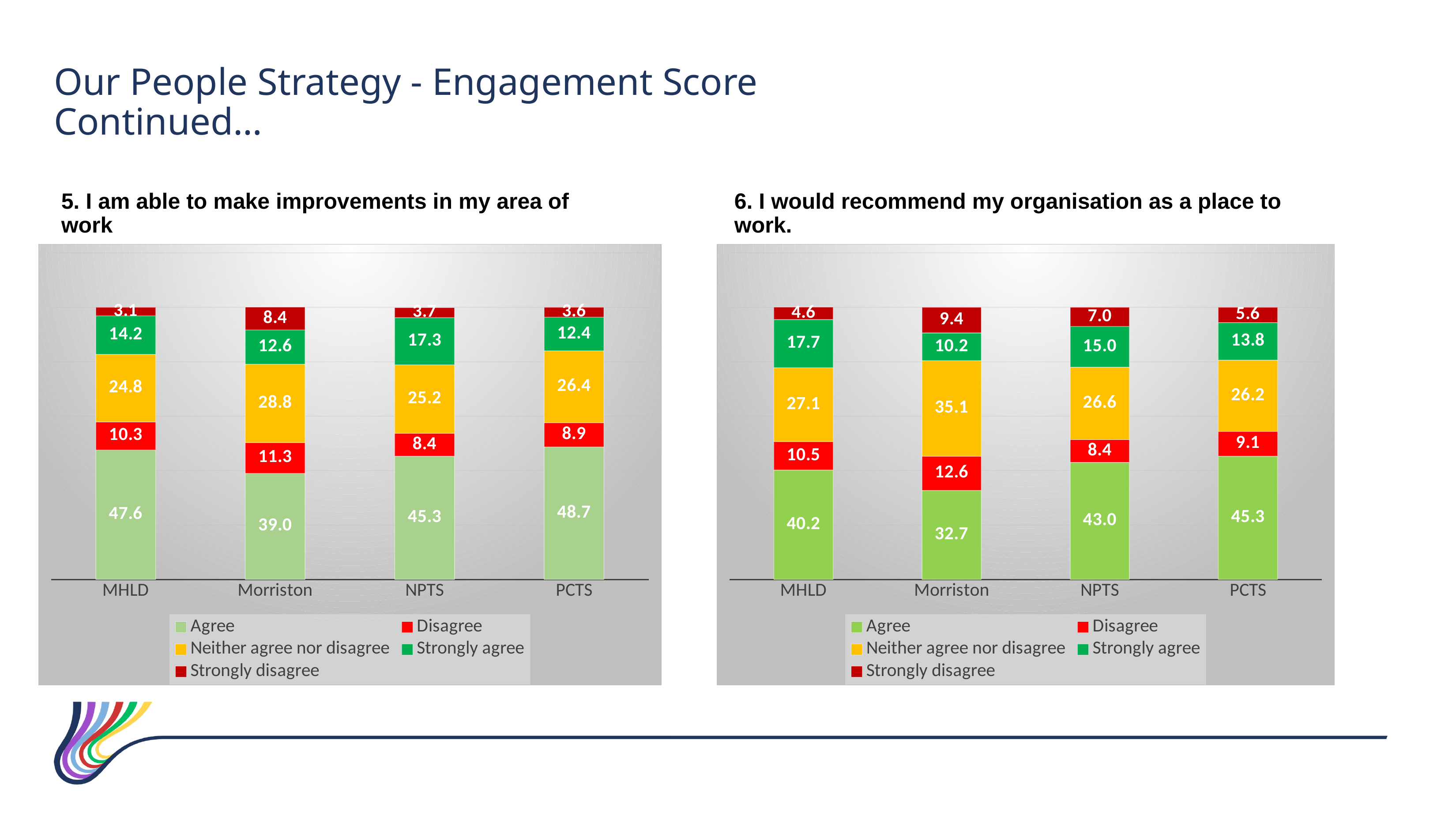
In the chart for question 5, which category has the highest Agree value? PCTS In the chart for question 6, which is larger: the Strongly disagree value for Morriston or for NPTS? Morriston In the chart for question 5, what is the Strongly disagree value for MHLD? 3.1 In the chart for question 6, what is the total of the stacked bar for NPTS? 100.0 In the chart for question 5 (I am able to make improvements in my area of work), what is the Agree value for Morriston? 39.0 How many series does the legend of the chart for question 5 list? 5 What kind of chart is used for question 5? Stacked bar chart In the chart for question 5, what is the difference between the Strongly agree values for NPTS and PCTS? 4.9 In the chart for question 6, which category has the lowest Agree value? Morriston In the chart for question 6, which colour represents Strongly agree in the legend? Green How many categories are shown on the x axis of the chart for question 6? 4 In the chart for question 6 (I would recommend my organisation as a place to work), what is the Neither agree nor disagree value for Morriston? 35.1